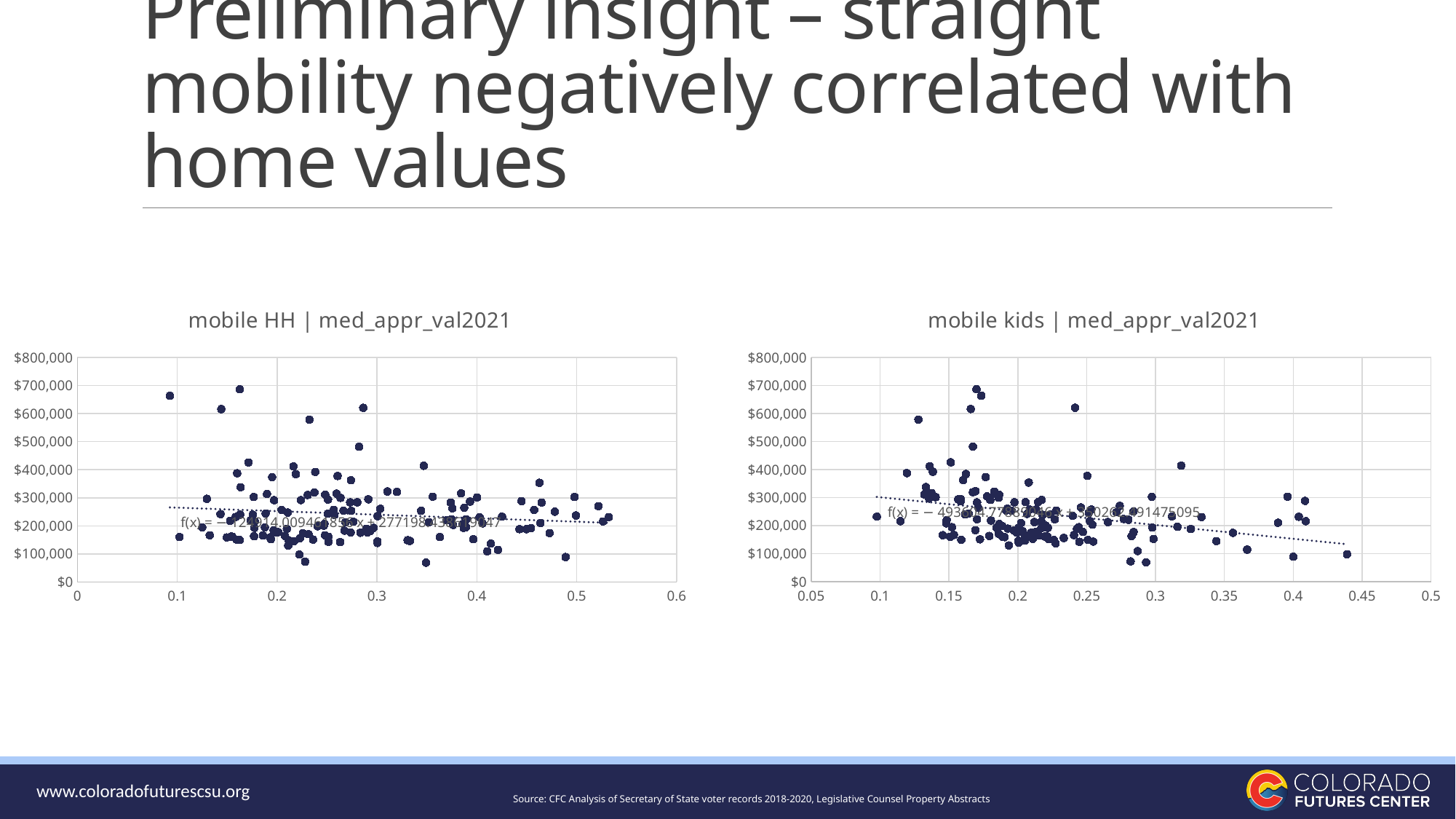
What kind of chart is the right chart titled "mobile kids | med_appr_val2021"? scatter chart In the left chart (mobile HH | med_appr_val2021), is the lowest plotted point greater or less than $100,000? less What kind of chart is the left chart titled "mobile HH | med_appr_val2021"? scatter chart In the left chart (mobile HH | med_appr_val2021), does the fitted trend line rise or fall as the x value increases? fall In the left chart (mobile HH | med_appr_val2021), is the highest plotted point greater or less than $600,000? greater In the right chart (mobile kids | med_appr_val2021), does the fitted trend line rise or fall as the x value increases? fall How many charts are shown on the slide? 2 What is the highest value shown on the y axis of the right chart (mobile kids | med_appr_val2021)? $800,000 In the right chart (mobile kids | med_appr_val2021), is the highest plotted point greater or less than $600,000? greater Which chart has the steeper downward trend line, the left chart (mobile HH) or the right chart (mobile kids)? the right chart (mobile kids) What is the title of the left chart? mobile HH | med_appr_val2021